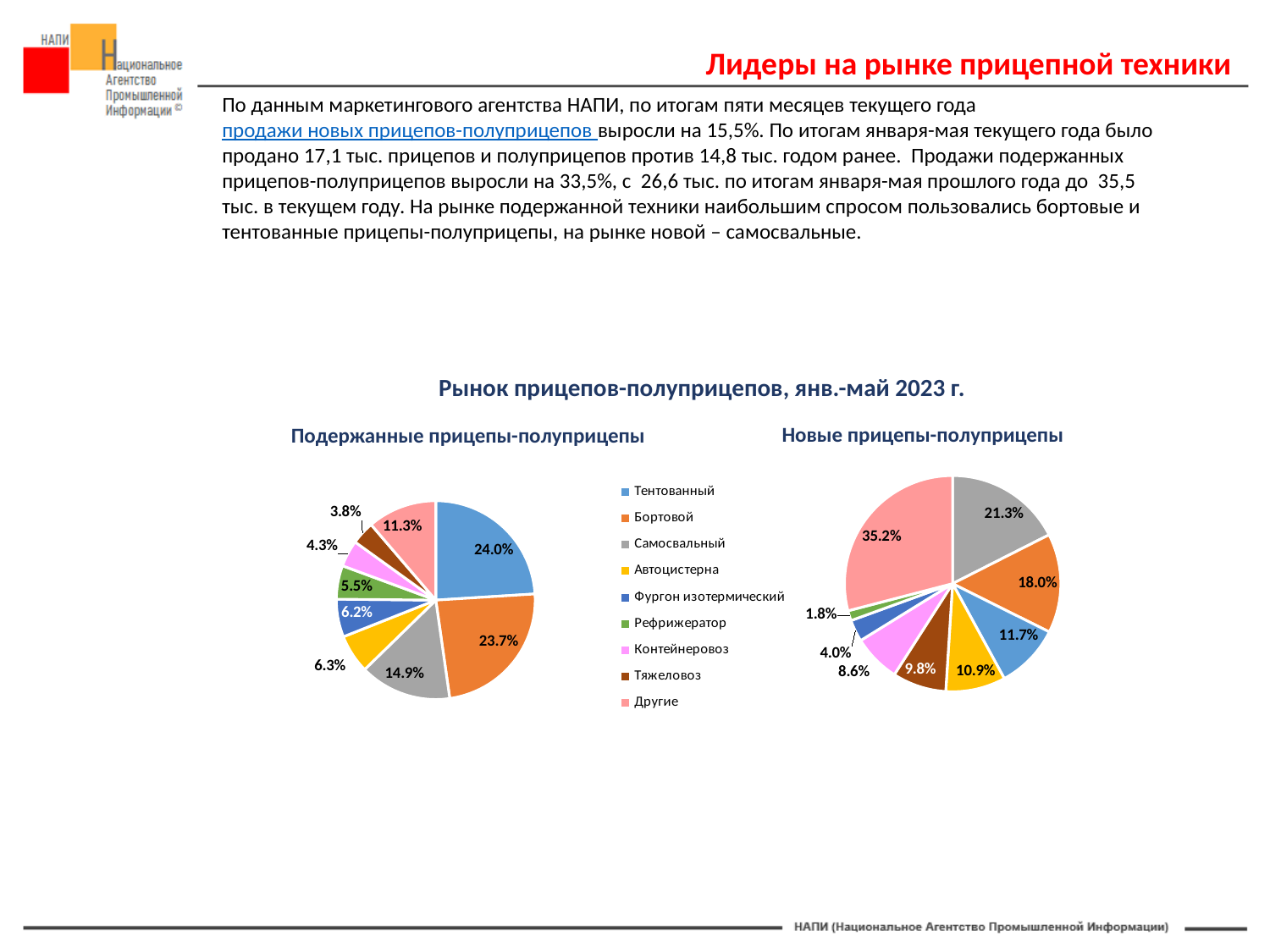
In the 'Новые прицепы-полуприцепы' pie chart, what share does 'Самосвальный' have? 21.3% What is the overall title above the two pie charts? Рынок прицепов-полуприцепов, янв.-май 2023 г. In the 'Новые прицепы-полуприцепы' pie chart, which category has the smallest share? Рефрижератор In the 'Подержанные прицепы-полуприцепы' pie chart, which category has the largest share? Тентованный In the 'Новые прицепы-полуприцепы' pie chart, which category has the largest share? Другие Is the share of 'Бортовой' larger in the 'Подержанные прицепы-полуприцепы' chart or in the 'Новые прицепы-полуприцепы' chart? Подержанные прицепы-полуприцепы In the 'Новые прицепы-полуприцепы' pie chart, what share does 'Автоцистерна' have? 10.9% How many categories does the shared legend of the two pie charts list? 9 In the 'Подержанные прицепы-полуприцепы' pie chart, what share does 'Тентованный' have? 24.0% What kind of charts are shown on the slide under 'Рынок прицепов-полуприцепов, янв.-май 2023 г.'? Pie charts In the 'Подержанные прицепы-полуприцепы' pie chart, what is the difference between the shares of 'Тентованный' and 'Бортовой'? 0.3 percentage points In the 'Подержанные прицепы-полуприцепы' pie chart, which category has the smallest share? Тяжеловоз